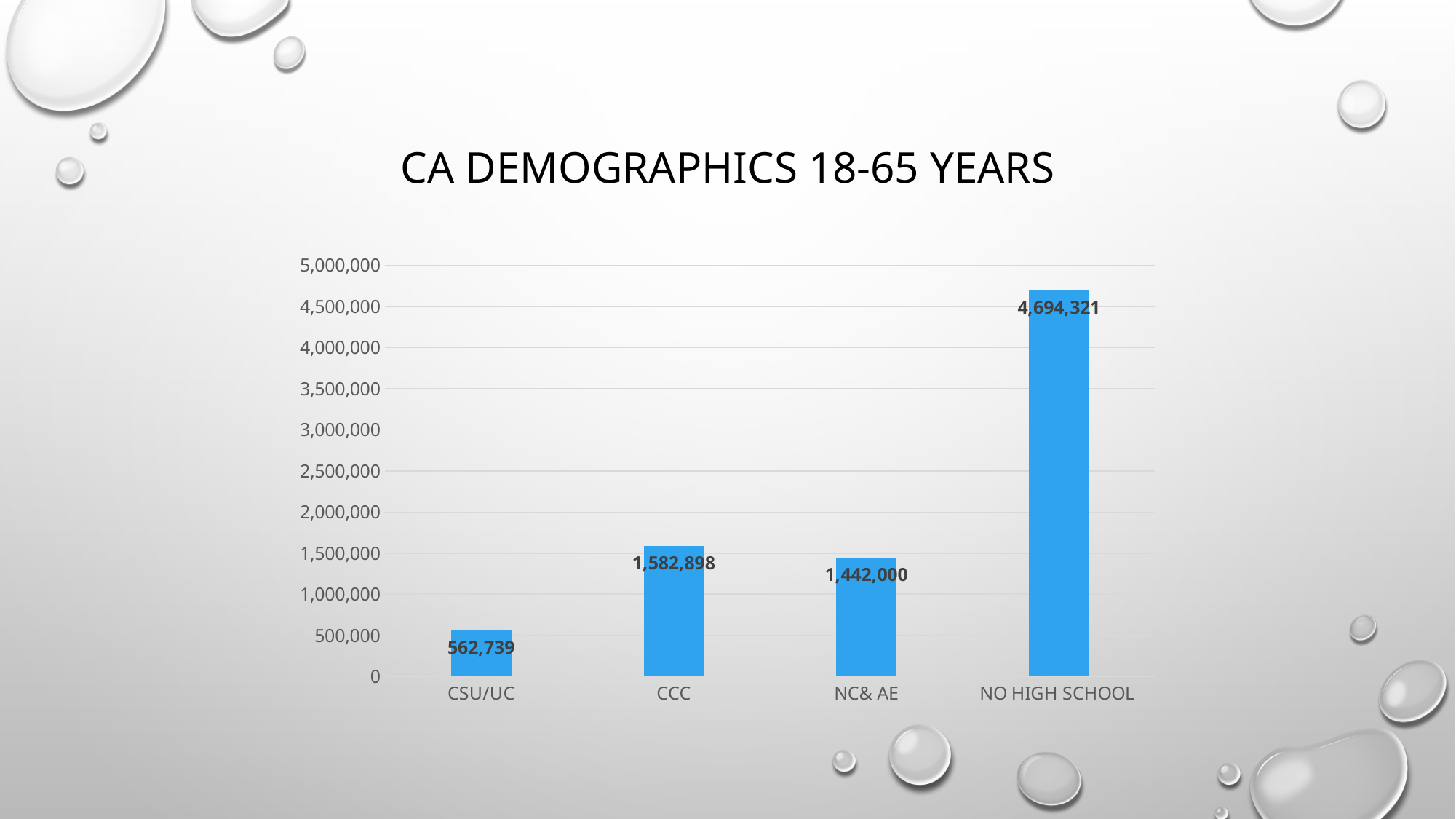
Which category has the lowest value? CSU/UC What is the value for NC& AE? 1,442,000 Which is larger, the value for CCC or the value for NC& AE? CCC How many categories are shown on the x axis? 4 Is the value for NO HIGH SCHOOL greater or less than 4,500,000? greater What is the difference between the values for CCC and NC& AE? 140,898 What is the difference between the values for NO HIGH SCHOOL and CSU/UC? 4,131,582 What is the value for CCC? 1,582,898 What is the value for NO HIGH SCHOOL? 4,694,321 What is the value for CSU/UC? 562,739 Which category has the highest value? NO HIGH SCHOOL What kind of chart is shown on the slide? bar chart